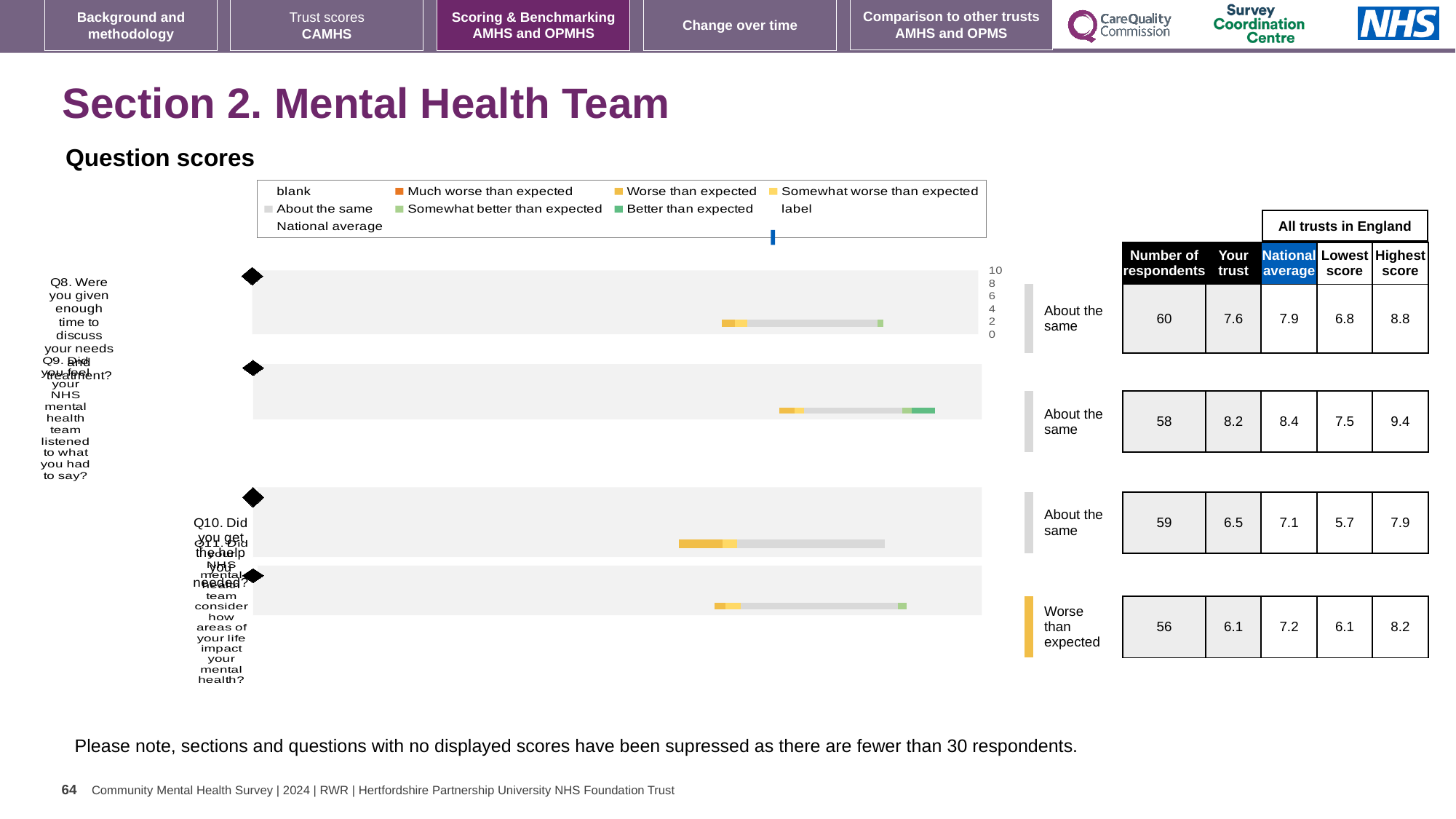
Which question is rated 'Worse than expected' rather than 'About the same'? Q11 What kind of chart is used to show the question scores on this slide? bar chart Which question has the highest 'Your trust' score? Q9 What is the highest score among all trusts in England for Q10 (Did you get the help you needed)? 7.9 How many entries does the legend of the question scores chart list? 9 What is the 'Your trust' score for Q8 (Were you given enough time to discuss your needs and treatment)? 7.6 For Q10, which is larger: the 'Your trust' score or the national average? National average What is the difference between the national average and the 'Your trust' score for Q8? 0.3 How many questions (bars) are plotted in the question scores chart? 4 How many respondents answered Q11 (Did your NHS mental health team consider how areas of your life impact your mental health)? 56 Which question has the lowest 'Your trust' score? Q11 What is the national average score for Q9 (Did you feel your NHS mental health team listened to what you had to say)? 8.4